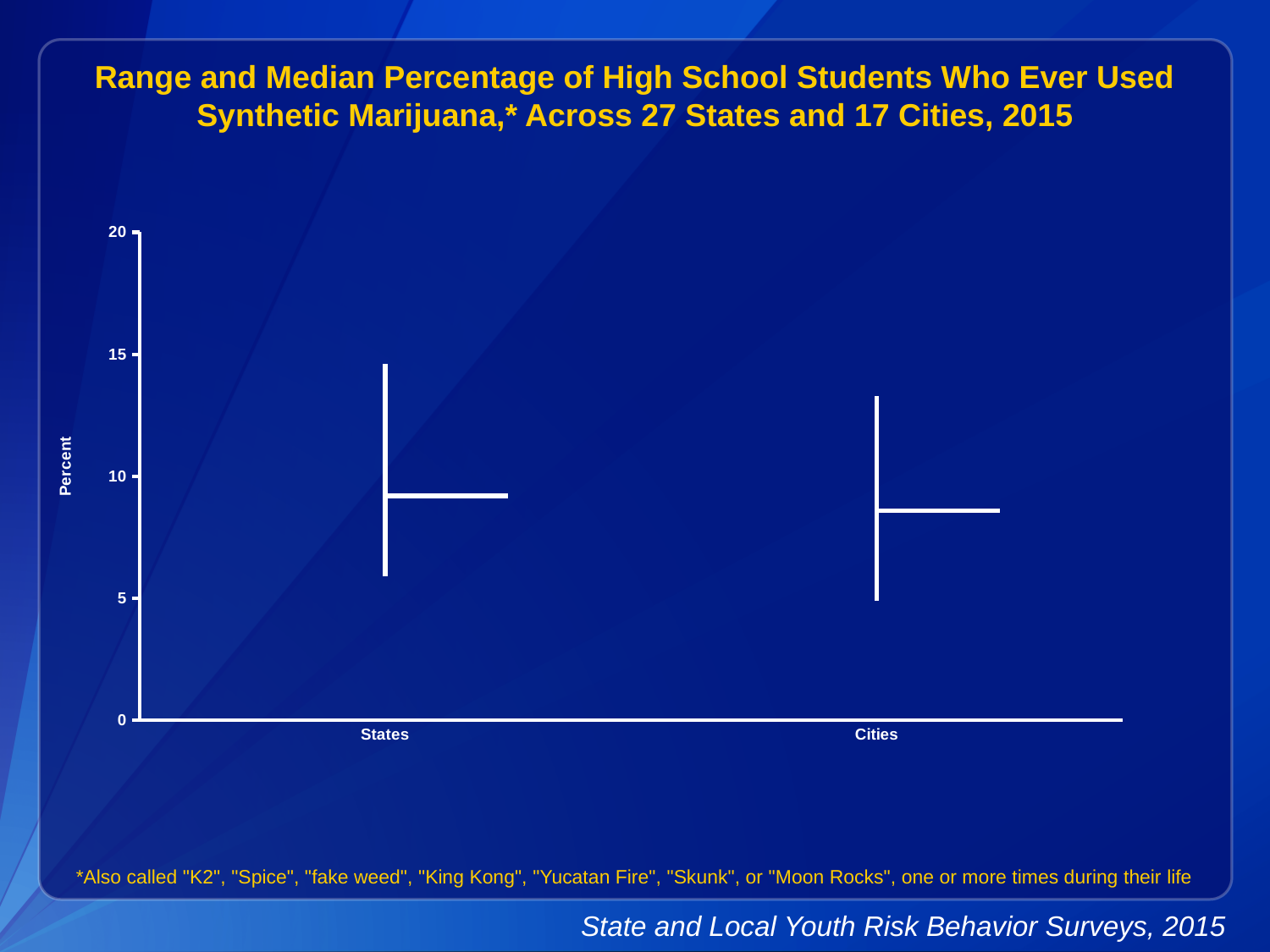
Is the median value for Cities greater or less than 5? greater Is the median value for States greater or less than 10? less What are the two categories shown on the x axis? States and Cities How many categories are shown on the x axis of the chart? 2 Is the top of the range for Cities greater or less than 10? greater Which category has the higher maximum (top of range), States or Cities? States What is the label of the y axis? Percent What is the highest value shown on the y axis? 20